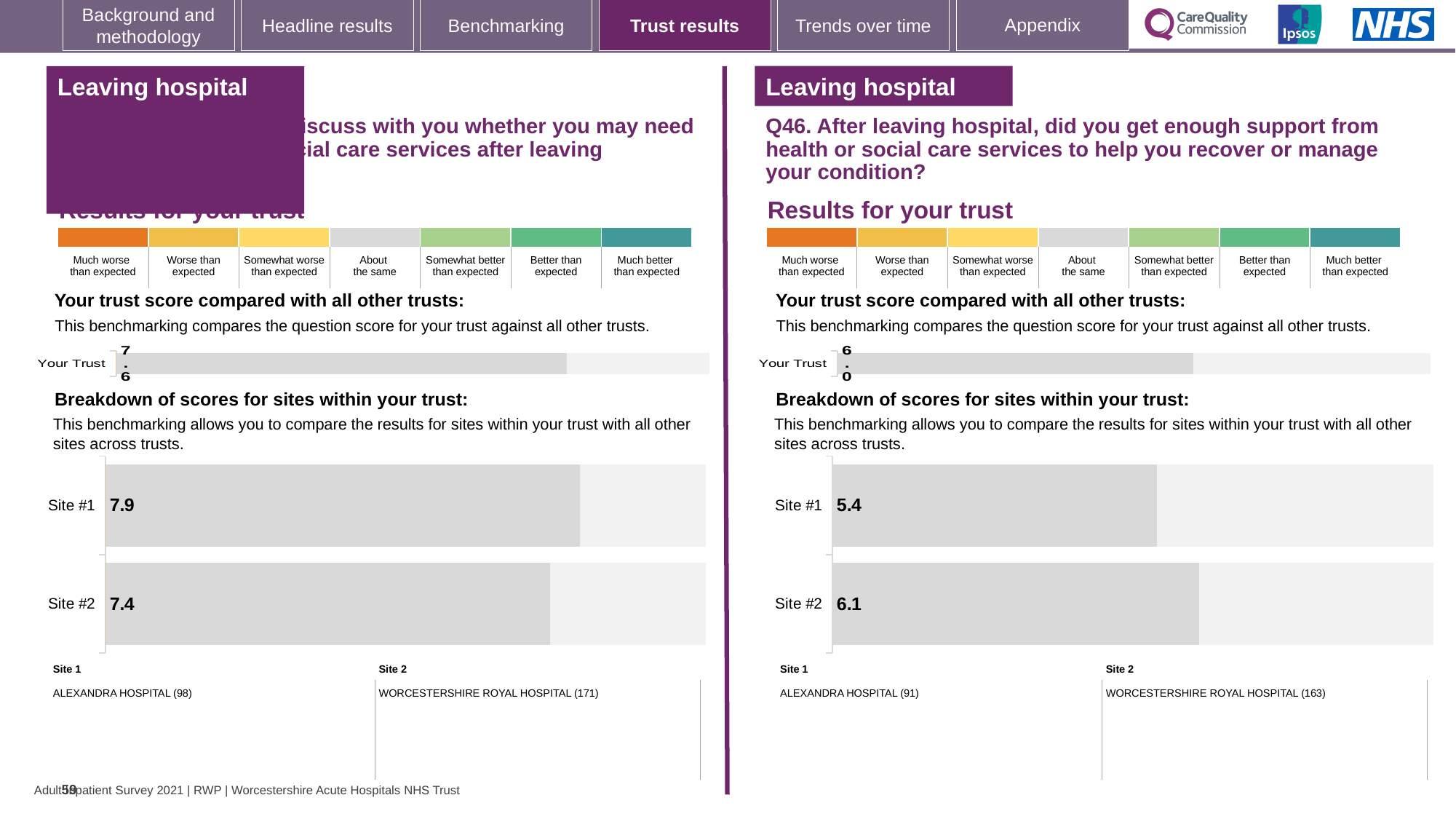
On the left-hand side of the slide, what is the score shown for Site #1 in the breakdown of scores for sites within your trust? 7.9 On the left-hand side of the slide, what is the score shown for Site #2 in the breakdown of scores for sites within your trust? 7.4 On the left-hand side of the slide, which site has the higher score in the site breakdown chart? Site #1 What kind of chart is used for the site breakdown on the right-hand side of the slide? Bar chart On the left-hand side of the slide, what is the 'Your Trust' score shown in the trust benchmarking bar? 7.6 In the Q46 site breakdown chart on the right-hand side of the slide, what is the score for Site #1? 5.4 In the Q46 trust benchmarking bar on the right-hand side of the slide, what is the 'Your Trust' score? 6.0 In the Q46 site breakdown chart on the right-hand side of the slide, what is the difference between the Site #2 and Site #1 scores? 0.7 On the left-hand side of the slide, what is the difference between the Site #1 and Site #2 scores in the site breakdown chart? 0.5 In the Q46 site breakdown chart on the right-hand side of the slide, which site has the lower score? Site #1 In the Q46 site breakdown chart on the right-hand side of the slide, what is the score for Site #2? 6.1 How many sites are shown in the Q46 site breakdown chart on the right-hand side of the slide? 2